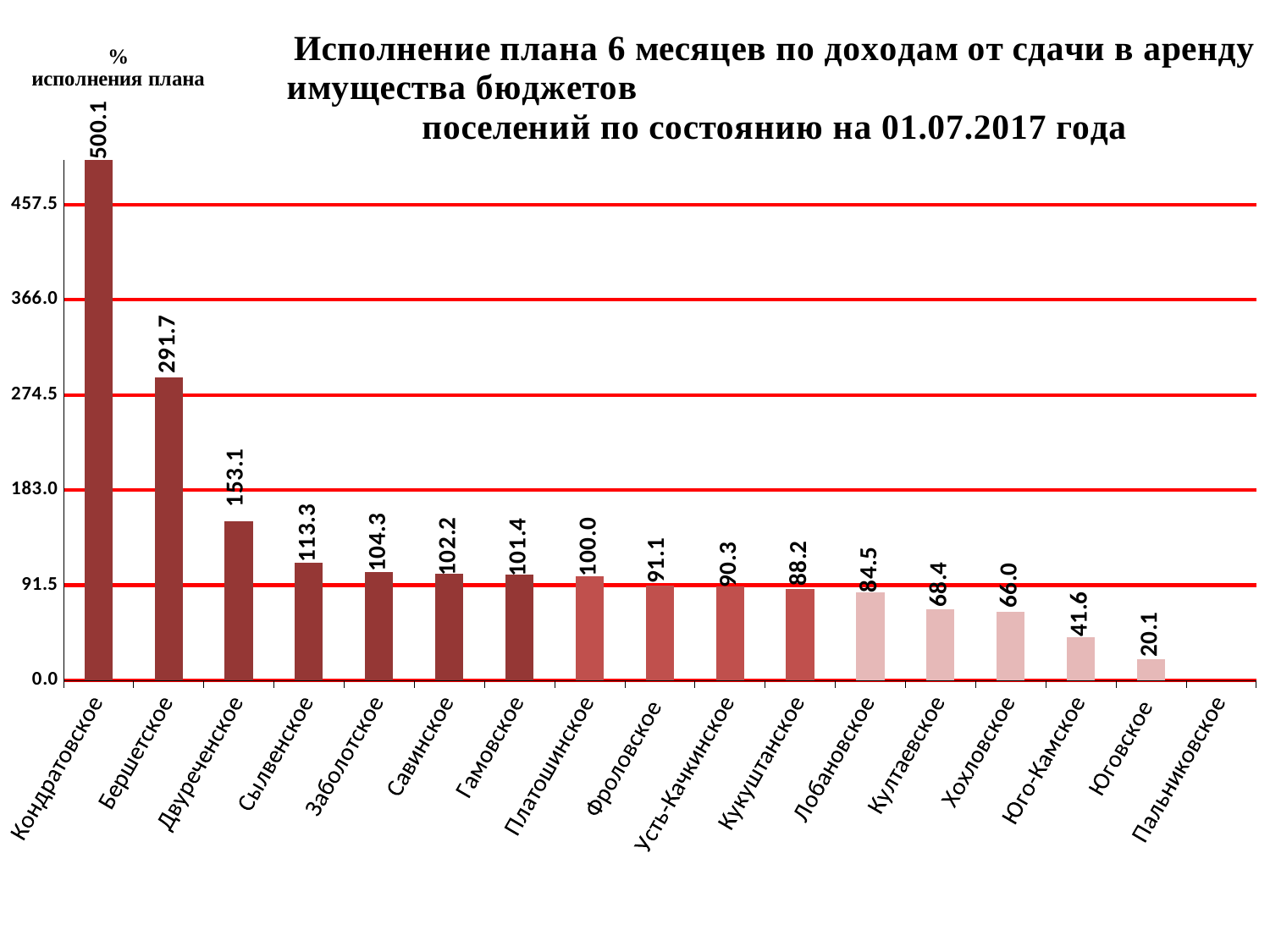
What is the difference between the values for Кондратовское and Бершетское? 208.4 How many categories are shown on the x axis? 17 What kind of chart is shown on the slide? bar chart Do the values rise or fall from left to right along the x axis? fall Is the value for Двуреченское greater or less than 183.0? less Which category has the lowest value among those with a printed data label? Юговское Which is larger, the value for Заболотское or the value for Савинское? Заболотское What is the value for Кондратовское? 500.1 What is the value for Сылвенское? 113.3 Which category has the highest value? Кондратовское What is the difference between the values for Платошинское and Кукуштанское? 11.8 What is the value for Юго-Камское? 41.6